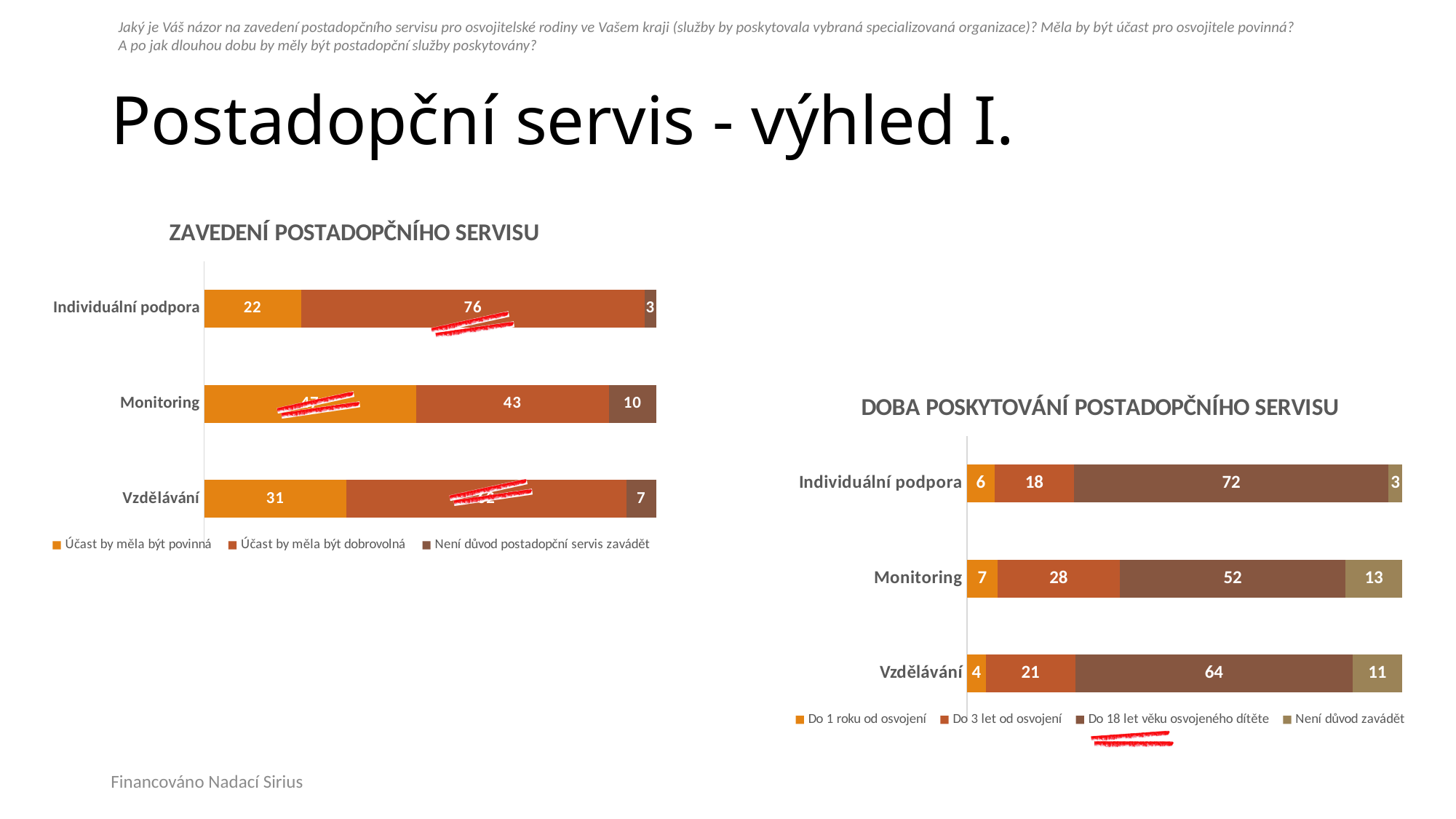
In the chart titled DOBA POSKYTOVÁNÍ POSTADOPČNÍHO SERVISU, what is the value for 'Do 18 let věku osvojeného dítěte' for Monitoring? 52 In the chart titled DOBA POSKYTOVÁNÍ POSTADOPČNÍHO SERVISU, what is the value for 'Do 3 let od osvojení' for Vzdělávání? 21 In the chart titled ZAVEDENÍ POSTADOPČNÍHO SERVISU, what is the value for 'Účast by měla být dobrovolná' for Individuální podpora? 76 In the chart titled ZAVEDENÍ POSTADOPČNÍHO SERVISU, how many series does the legend list? 3 In the chart titled DOBA POSKYTOVÁNÍ POSTADOPČNÍHO SERVISU, which category has the lowest value for 'Není důvod zavádět'? Individuální podpora In the chart titled DOBA POSKYTOVÁNÍ POSTADOPČNÍHO SERVISU, how many series does the legend list? 4 In the chart titled ZAVEDENÍ POSTADOPČNÍHO SERVISU, what is the difference between the 'Účast by měla být dobrovolná' value and the 'Účast by měla být povinná' value for Individuální podpora? 54 In the chart titled ZAVEDENÍ POSTADOPČNÍHO SERVISU, what is the value for 'Není důvod postadopční servis zavádět' for Monitoring? 10 In the chart titled DOBA POSKYTOVÁNÍ POSTADOPČNÍHO SERVISU, what is the total of the stacked bar for Monitoring? 100 In the chart titled DOBA POSKYTOVÁNÍ POSTADOPČNÍHO SERVISU, which category has the highest value for 'Do 18 let věku osvojeného dítěte'? Individuální podpora In the chart titled ZAVEDENÍ POSTADOPČNÍHO SERVISU, what is the value for 'Účast by měla být povinná' for Vzdělávání? 31 What kind of chart is the chart titled DOBA POSKYTOVÁNÍ POSTADOPČNÍHO SERVISU? Stacked bar chart